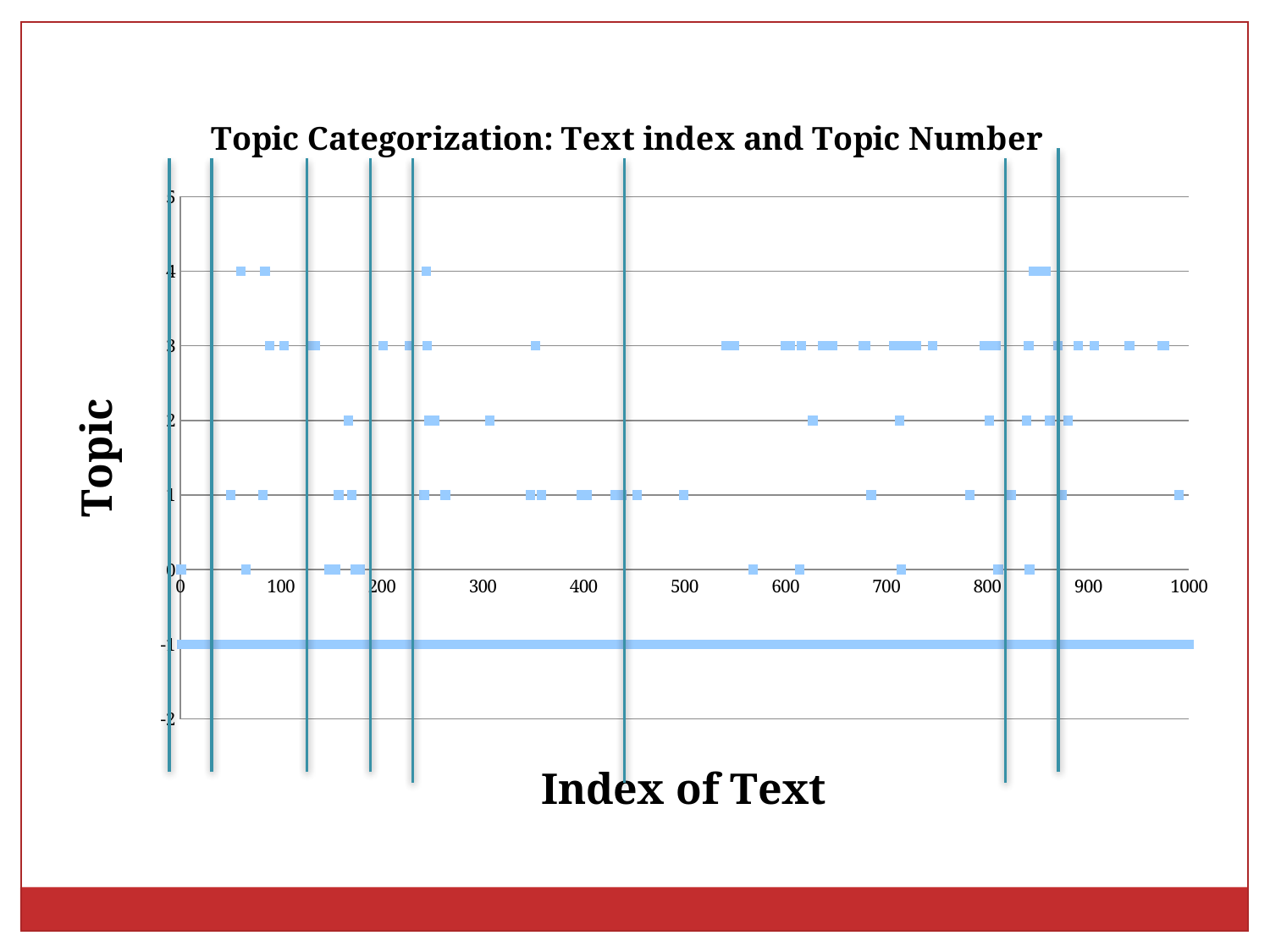
Are there any points plotted at topic level 5? No How many distinct topic levels have points plotted on them? 6 What is the highest topic value at which any points are plotted? 4 What kind of chart is shown on the slide? scatter chart What is the lowest value shown on the y axis? -2 What is the label of the x axis? Index of Text What is the title of the chart? Topic Categorization: Text index and Topic Number Is the highest plotted topic value greater or less than 5? less What is the lowest topic value at which any points are plotted? -1 Among topic levels 0 to 4, which level has the most plotted points? 3 What is the largest value shown on the x axis? 1000